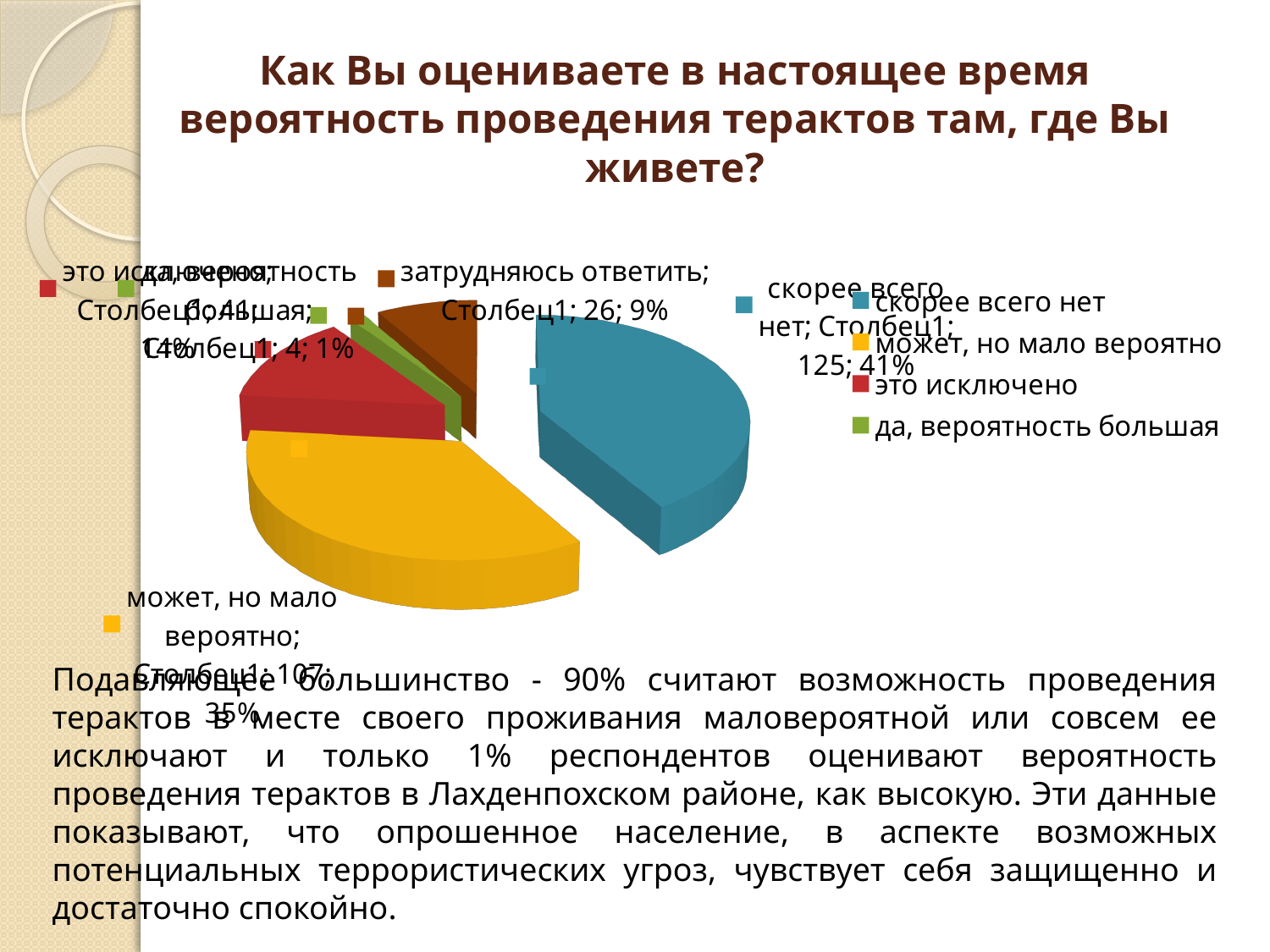
Which category has the smallest slice in the pie chart? да, вероятность большая How many entries does the legend of the pie chart list? 5 What percentage share is shown for the slice "скорее всего нет"? 41% What count value is shown for the slice "может, но мало вероятно"? 107 What is the difference between the counts for "скорее всего нет" and "может, но мало вероятно"? 18 How many categories (slices) does the pie chart have? 5 What percentage share is shown for the slice "да, вероятность большая"? 1% Which category has the largest slice in the pie chart? скорее всего нет What kind of chart is shown on the slide? pie chart What is the title of the chart on the slide? Как Вы оцениваете в настоящее время вероятность проведения терактов там, где Вы живете? Which slice is larger: "затрудняюсь ответить" or "да, вероятность большая"? затрудняюсь ответить What count value is shown for the slice "затрудняюсь ответить"? 26